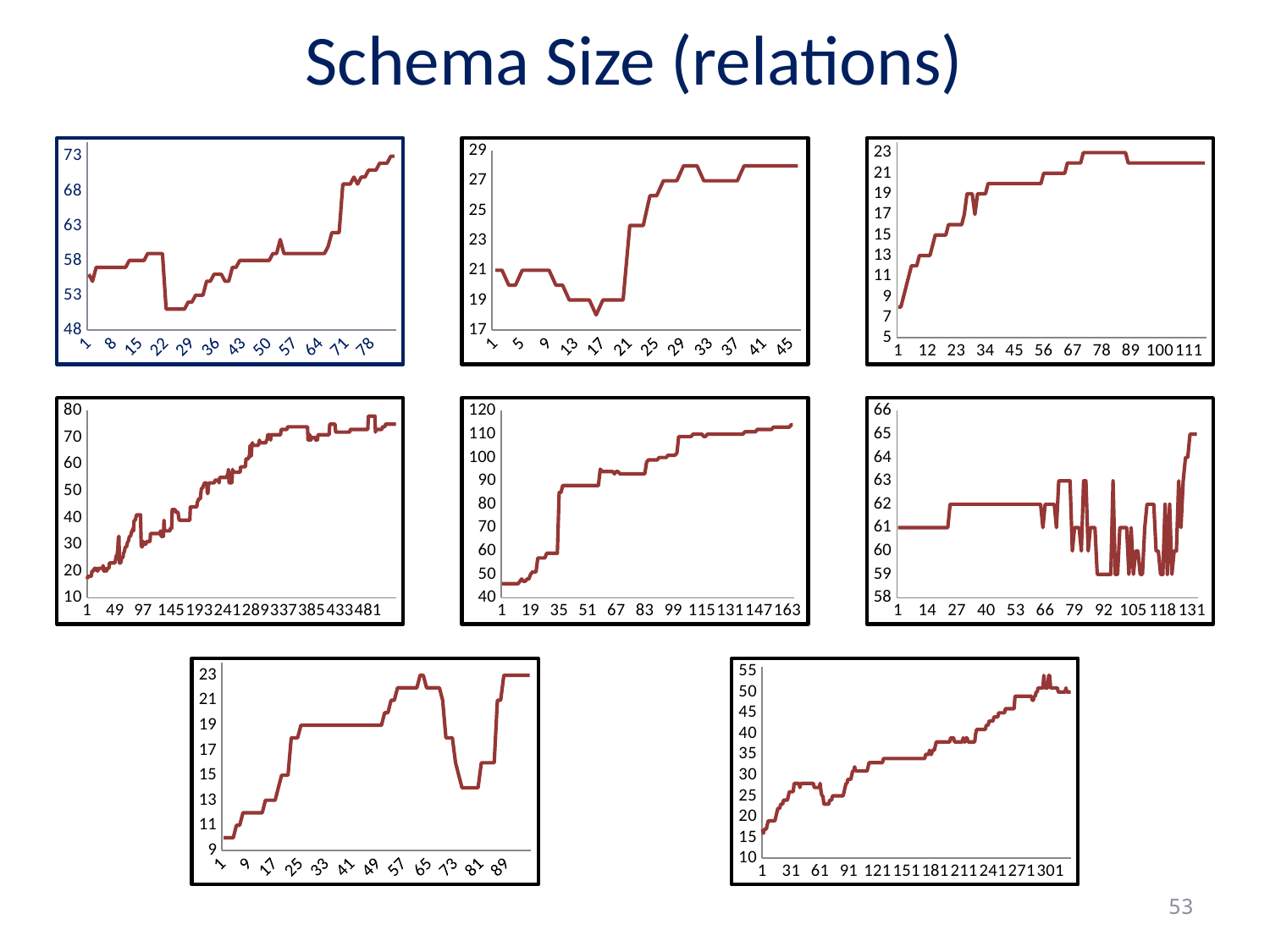
In the bottom-right chart, is the value at x = 1 greater or less than 20? less In the top-middle chart, is the value at x = 25 greater or less than 23? greater What is the title of the slide containing these charts? Schema Size (relations) In the bottom-left chart, is the value at x = 81 greater or less than 15? greater How many charts are shown on the slide? 8 In the middle-middle chart, do the values generally rise or fall along the x axis? rise What kind of chart is the top-left chart on the slide? line chart